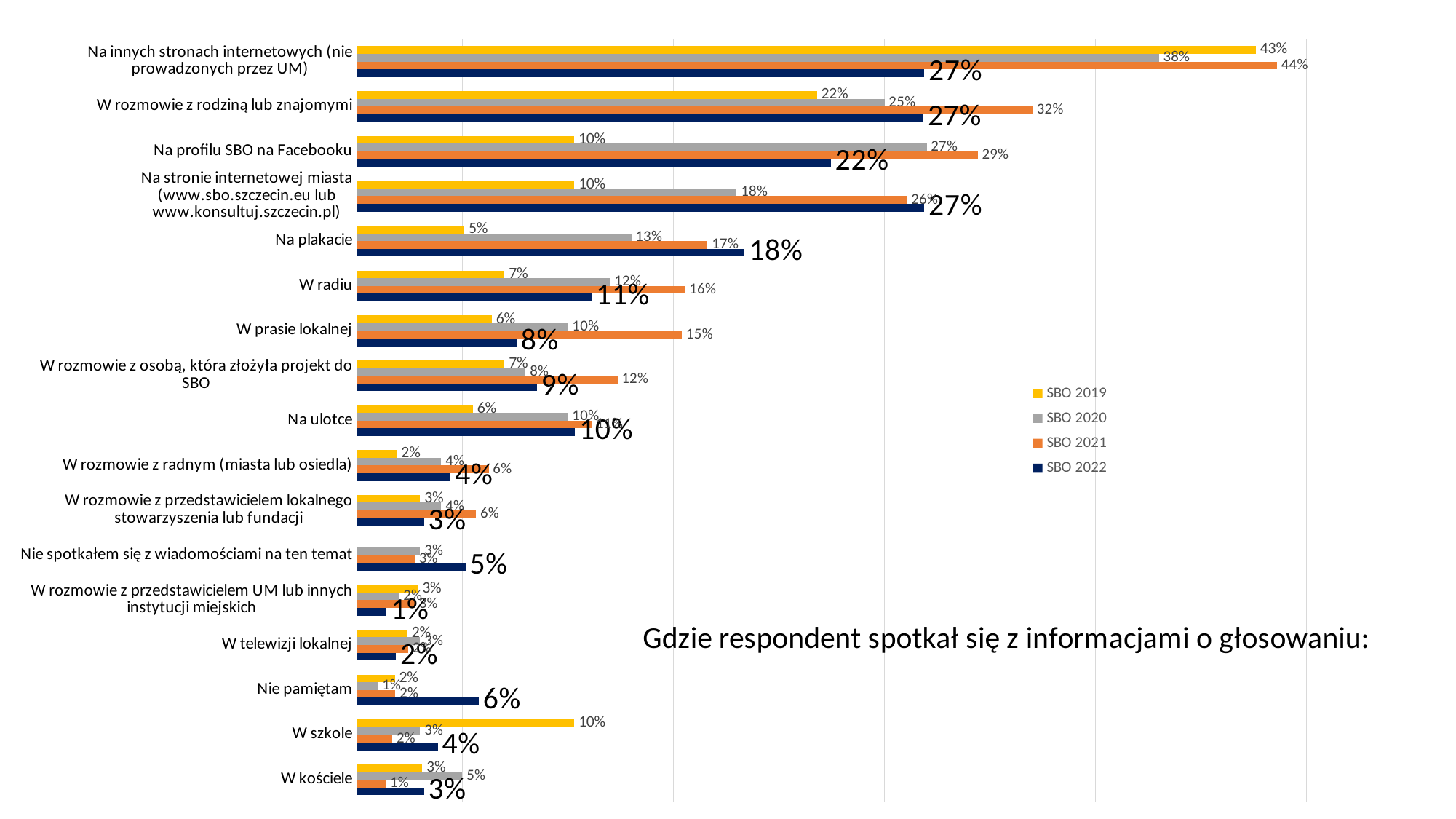
What is the title of the chart? Gdzie respondent spotkał się z informacjami o głosowaniu: What is the difference between the SBO 2022 and SBO 2020 values for 'Nie pamiętam'? 5 percentage points What is the difference between the SBO 2019 and SBO 2022 values for 'Na innych stronach internetowych (nie prowadzonych przez UM)'? 16 percentage points What kind of chart is shown on the slide? bar chart How many series does the legend list? 4 What is the SBO 2022 value for 'Na plakacie'? 18% For 'W rozmowie z rodziną lub znajomymi', which is larger: the SBO 2021 value or the SBO 2019 value? SBO 2021 What is the SBO 2019 value for 'W szkole'? 10% How many categories are plotted on the chart? 17 What is the SBO 2020 value for 'Na profilu SBO na Facebooku'? 27% What is the SBO 2021 value for 'Na innych stronach internetowych (nie prowadzonych przez UM)'? 44% Which category has the highest SBO 2021 value? Na innych stronach internetowych (nie prowadzonych przez UM)